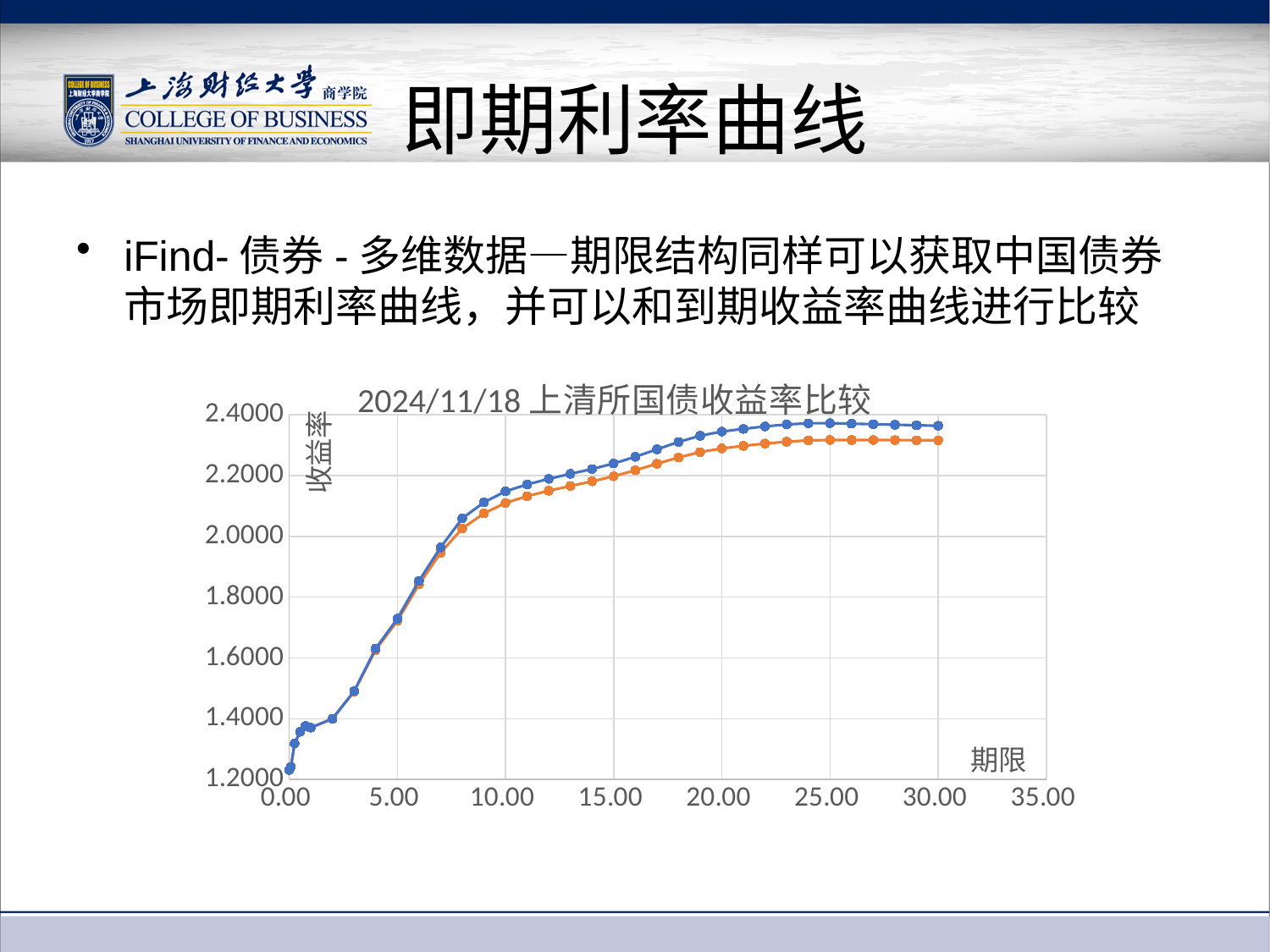
What is the title of the chart? 2024/11/18 上清所国债收益率比较 At 期限 = 5.00, is the plotted value greater or less than 1.6000? greater At 期限 = 30.00, is the blue line's value greater or less than 2.2000? greater What is the label of the x axis of the chart? 期限 Do the plotted values generally rise or fall as 期限 increases from 0.00 to 30.00? Rise At 期限 = 5.00, is the plotted value greater or less than 1.8000? less What type of chart is shown on the slide? Line chart At which 期限 value do the lines reach their lowest point? 0.00 At 期限 = 30.00, which line has the higher value, the blue line or the orange line? Blue line Is the value at 期限 = 20.00 larger than the value at 期限 = 5.00? Yes